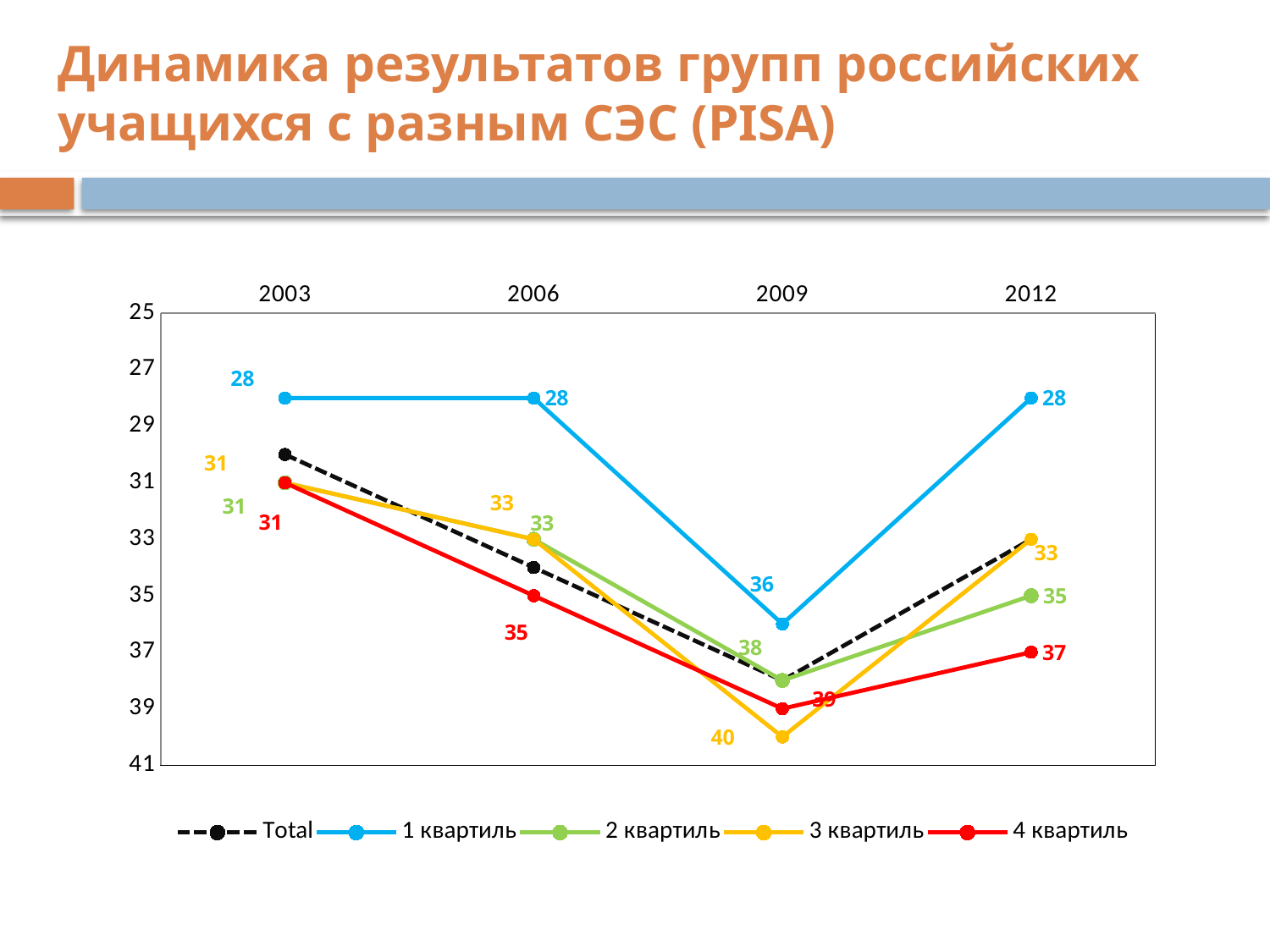
Which series is drawn with a dashed black line? Total What is the value for 2 квартиль in 2012? 35 What is the value for 4 квартиль in 2006? 35 What is the difference between the 4 квартиль value in 2009 and its value in 2003? 8 What is the value for 3 квартиль in 2009? 40 What is the value for 1 квартиль in 2009? 36 How many years are shown on the x axis? 4 What is the value for 4 квартиль in 2012? 37 What is the difference between the 3 квартиль value and the 1 квартиль value in 2009? 4 How many series does the legend list? 5 What kind of chart is this? line chart What is the value for 2 квартиль in 2006? 33